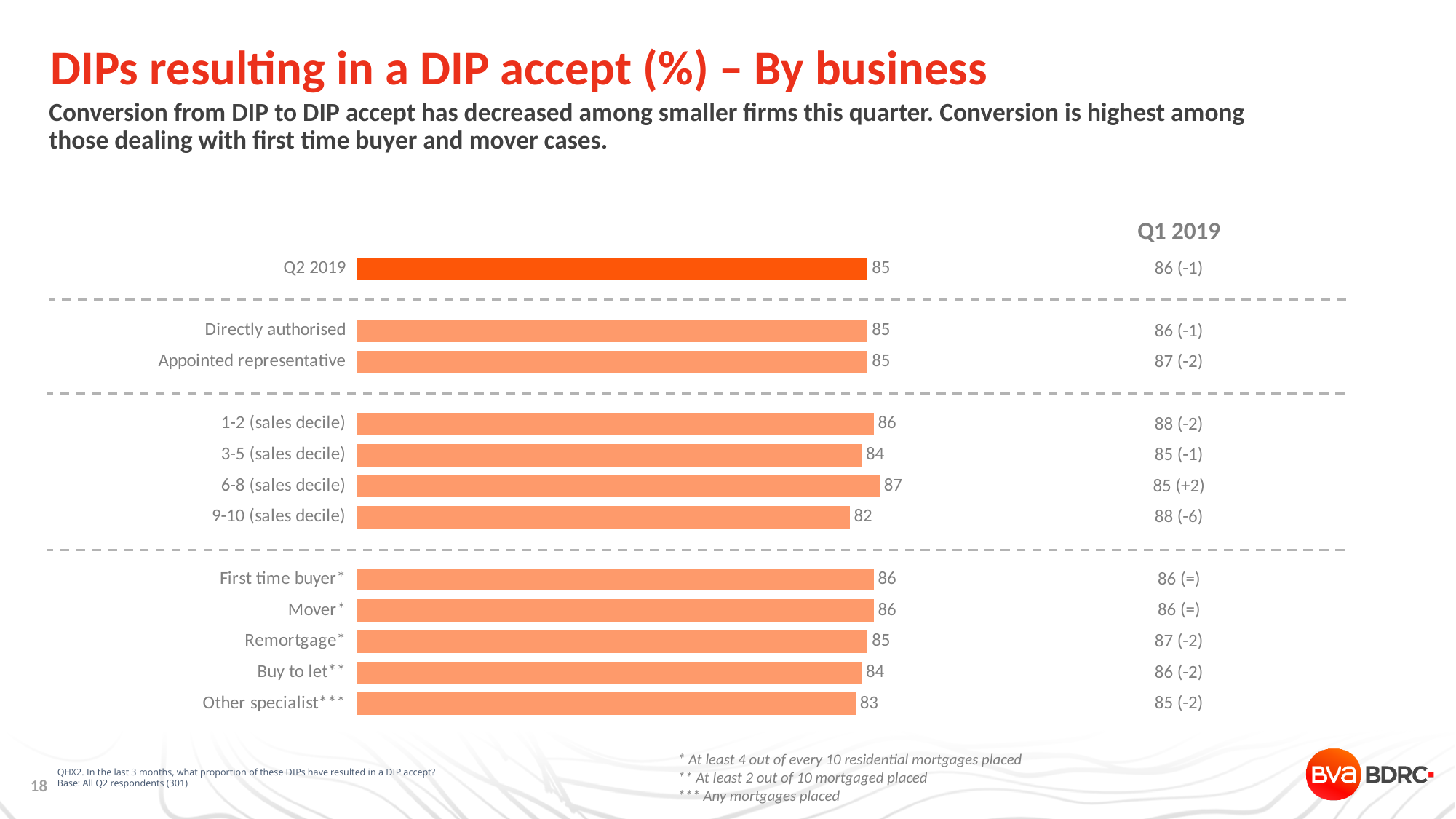
What is the Q1 2019 value shown for 9-10 (sales decile)? 88 (-6) What is the value for 9-10 (sales decile)? 82 Which is larger, the value for First time buyer or the value for Buy to let? First time buyer What is the difference between the values for 6-8 (sales decile) and 9-10 (sales decile)? 5 How many bars are plotted on the chart? 12 What is the value for Other specialist? 83 What is the value for 6-8 (sales decile)? 87 What is the difference between the values for Mover and Other specialist? 3 Which category has the highest value? 6-8 (sales decile) What is the Q2 2019 overall value shown at the top of the chart? 85 What kind of chart is shown on the slide? Bar chart Which category has the lowest value? 9-10 (sales decile)